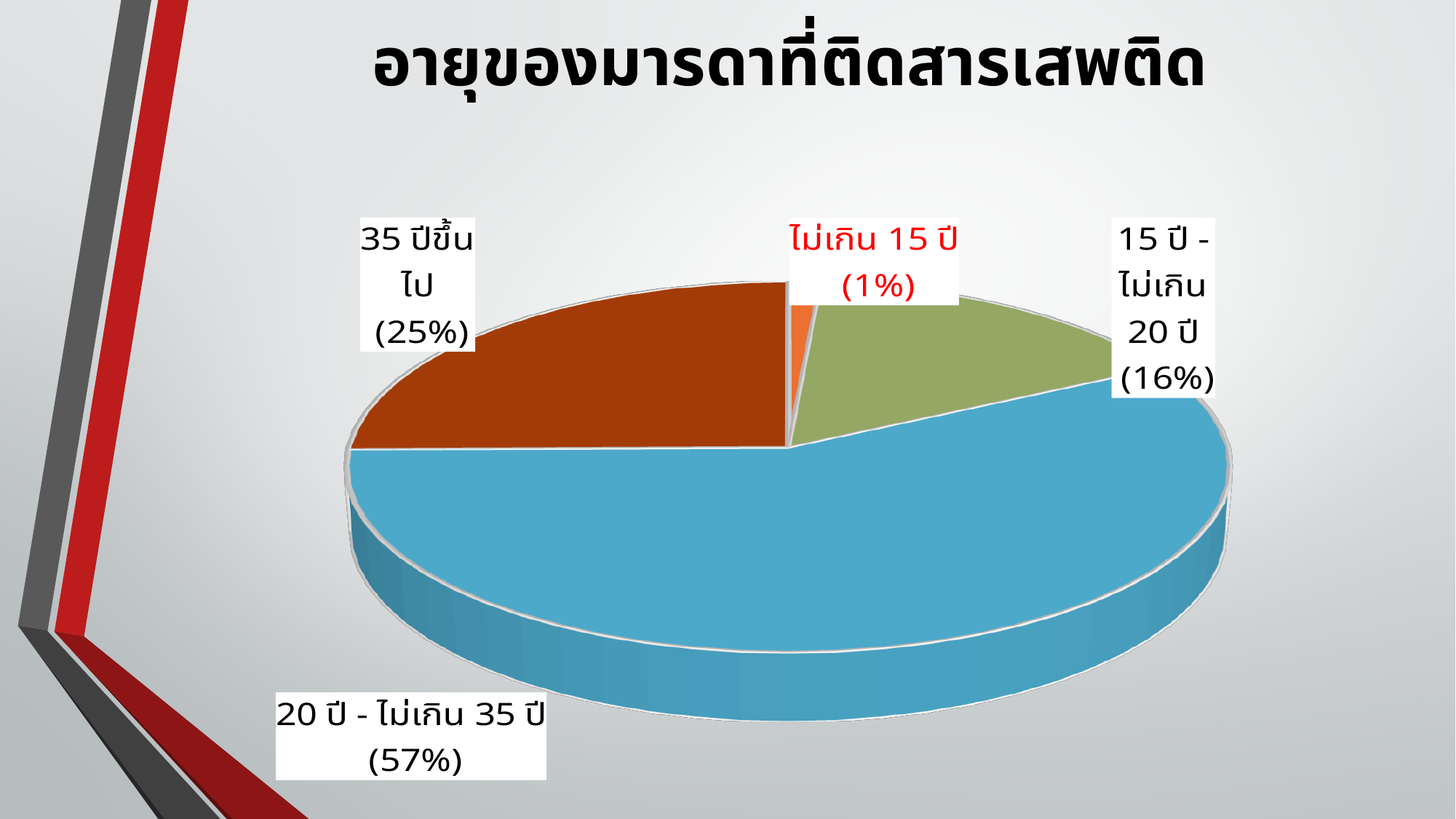
Which age group has the smallest share of the pie? ไม่เกิน 15 ปี What share of the pie does the slice '35 ปีขึ้นไป' represent? 25% What share of the pie does the slice '20 ปี - ไม่เกิน 35 ปี' represent? 57% What colour is the slice for '20 ปี - ไม่เกิน 35 ปี'? Blue How many slices does the pie chart have? 4 Which age group has the largest share of the pie? 20 ปี - ไม่เกิน 35 ปี What is the title of the chart? อายุของมารดาที่ติดสารเสพติด What share of the pie does the slice '15 ปี - ไม่เกิน 20 ปี' represent? 16% What is the difference in percentage points between the '20 ปี - ไม่เกิน 35 ปี' slice and the '35 ปีขึ้นไป' slice? 32 Which slice is larger: '35 ปีขึ้นไป' or '15 ปี - ไม่เกิน 20 ปี'? 35 ปีขึ้นไป What kind of chart is shown on the slide? Pie chart